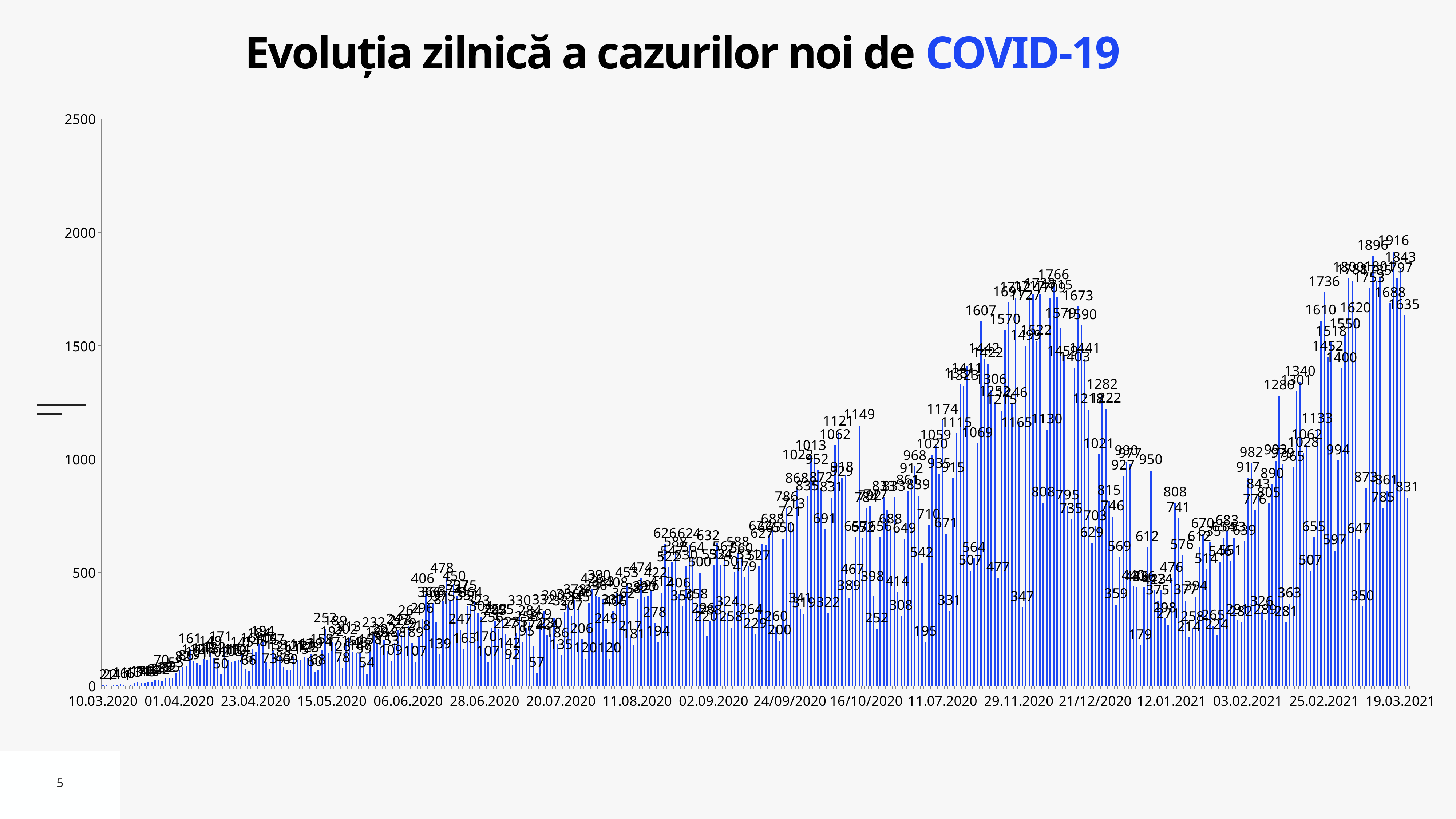
What is the maximum value shown on the vertical axis? 2500 What is the title of the chart on the slide? Evoluția zilnică a cazurilor noi de COVID-19 What is the first date label on the x axis? 10.03.2020 What is the last date label on the x axis? 19.03.2021 Which peak is higher: the one around 29.11.2020 or the one around 19.03.2021? the one around 19.03.2021 What kind of chart is shown on the slide? bar chart How many date labels are shown on the x axis? 18 Is the value for 15.05.2020 greater or less than 500? less Overall, do the daily values rise or fall from 10.03.2020 to 19.03.2021? rise Is the value for 10.03.2020 greater or less than 500? less What is the highest value labelled on the chart? 1916